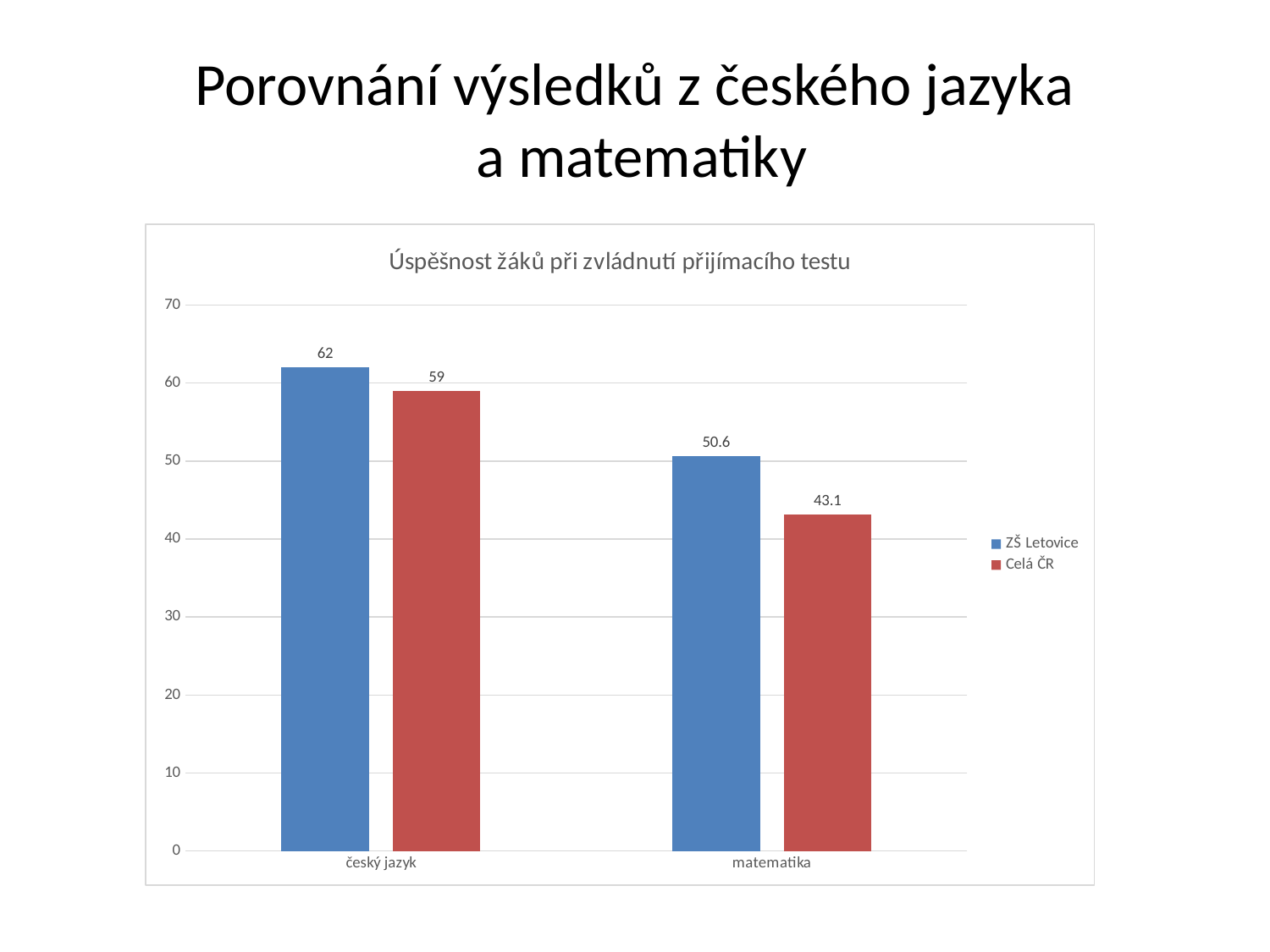
What is the value for ZŠ Letovice in matematika? 50.6 What is the value for Celá ČR in český jazyk? 59 What is the title of the chart? Úspěšnost žáků při zvládnutí přijímacího testu Which bar has the highest value in the chart? ZŠ Letovice, český jazyk What is the value for Celá ČR in matematika? 43.1 What is the difference between ZŠ Letovice and Celá ČR in matematika? 7.5 How many series does the legend list? 2 What is the difference between ZŠ Letovice and Celá ČR in český jazyk? 3 Which is larger: ZŠ Letovice in český jazyk or ZŠ Letovice in matematika? ZŠ Letovice in český jazyk What kind of chart is shown on the slide? Bar chart Which bar has the lowest value in the chart? Celá ČR, matematika What is the value for ZŠ Letovice in český jazyk? 62